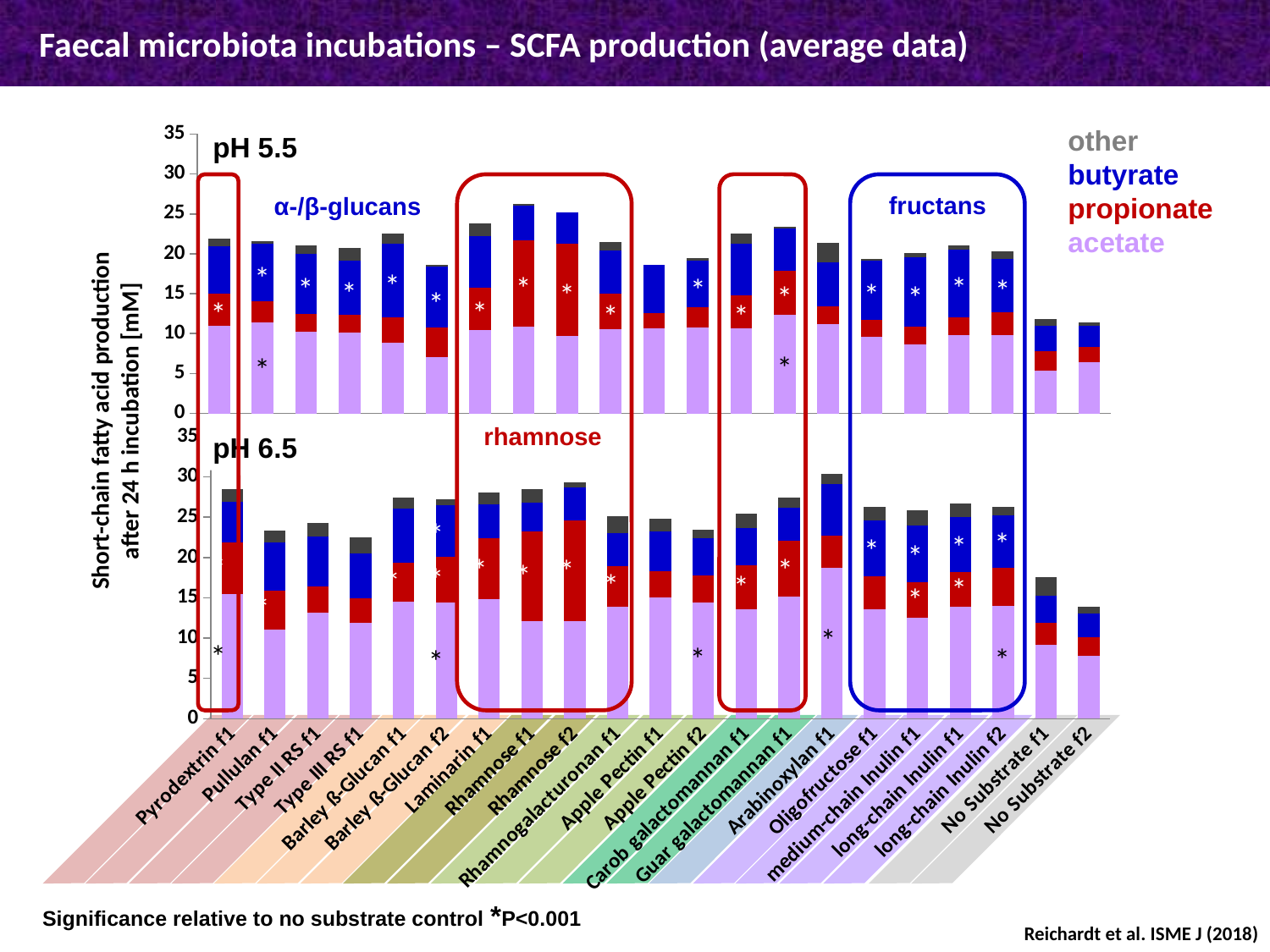
How many substrate categories are shown along the x axis? 21 In the pH 6.5 chart, which has the larger total: Arabinoxylan f1 or Pullulan f1? Arabinoxylan f1 In the pH 5.5 chart, is the total value for No Substrate f1 greater or less than 15? less In the pH 6.5 chart, which substrate has the lowest total short-chain fatty acid production? No Substrate f2 How many series does the legend list? 4 What kind of chart is used on this slide for the pH 5.5 and pH 6.5 panels? Stacked bar chart In the pH 6.5 chart, which substrate has the highest total short-chain fatty acid production? Arabinoxylan f1 What is the title of the slide? Faecal microbiota incubations – SCFA production (average data) In the pH 5.5 chart, is the total value for Rhamnose f1 greater or less than 20? greater In the pH 6.5 chart, is the total value for Arabinoxylan f1 greater or less than 25? greater In the pH 5.5 chart, which substrate has the highest total short-chain fatty acid production? Rhamnose f1 Which colour represents acetate in the legend? Purple (lavender)